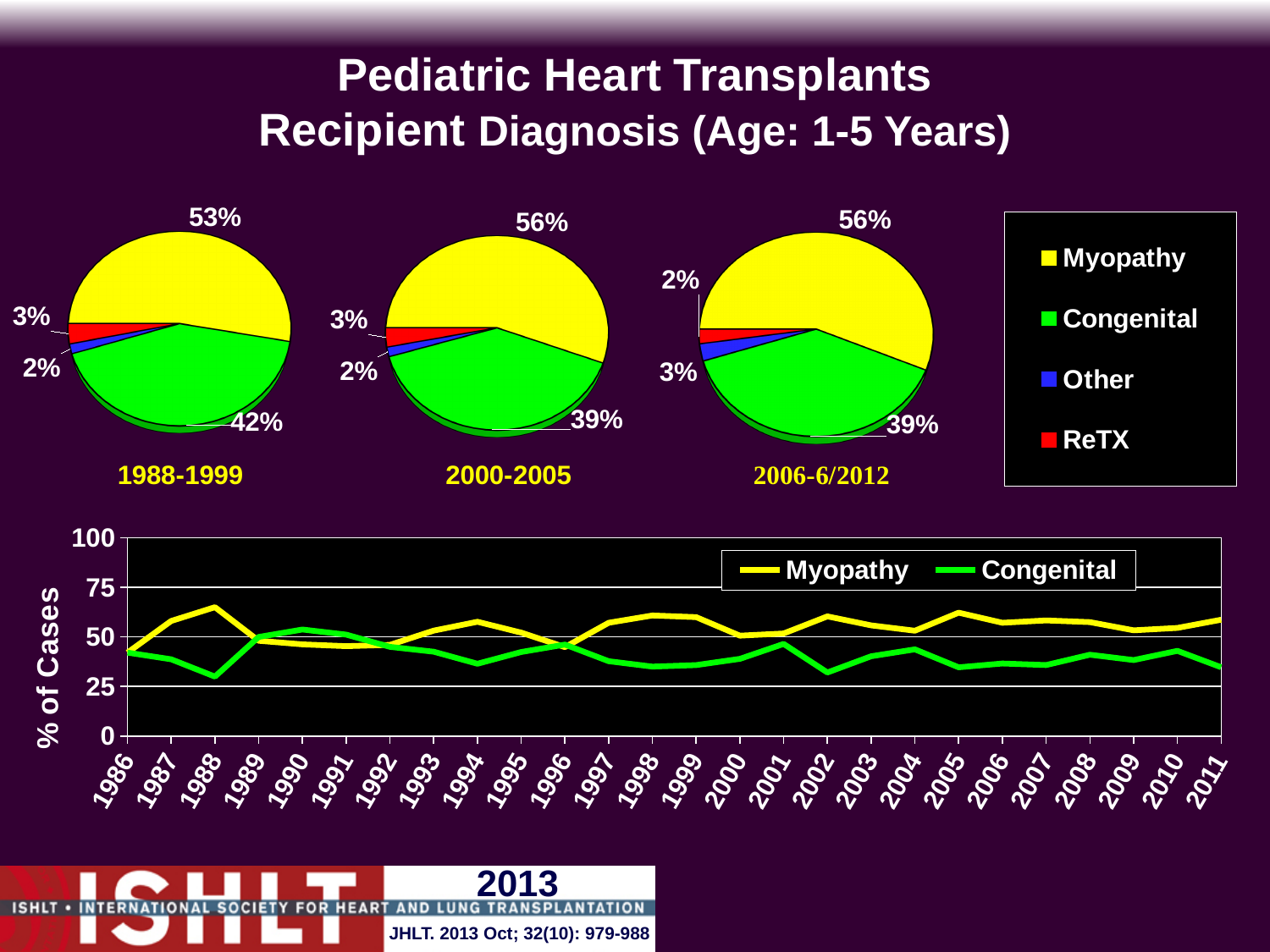
In the bottom line chart, which series is higher in 1988, Myopathy or Congenital? Myopathy In the bottom line chart, is the Myopathy value for 1988 greater or less than 50? greater How many entries does the legend of the pie charts list? 4 In the bottom line chart, how many years are shown on the x axis? 26 In the 1988-1999 pie chart, what share of cases is Myopathy? 53% In the 1988-1999 pie chart, which diagnosis has the largest slice? Myopathy In the 1988-1999 pie chart, how many percentage points larger is the Myopathy share than the Congenital share? 11 percentage points In the bottom line chart, how many series does the legend list? 2 What kind of chart is the chart at the bottom of the slide showing % of Cases by year? Line chart What kind of chart is used for the three charts in the top row of the slide? Pie chart In the 2000-2005 pie chart, what share of cases is Congenital? 39% In the 2006-6/2012 pie chart, what share of cases is Myopathy? 56%